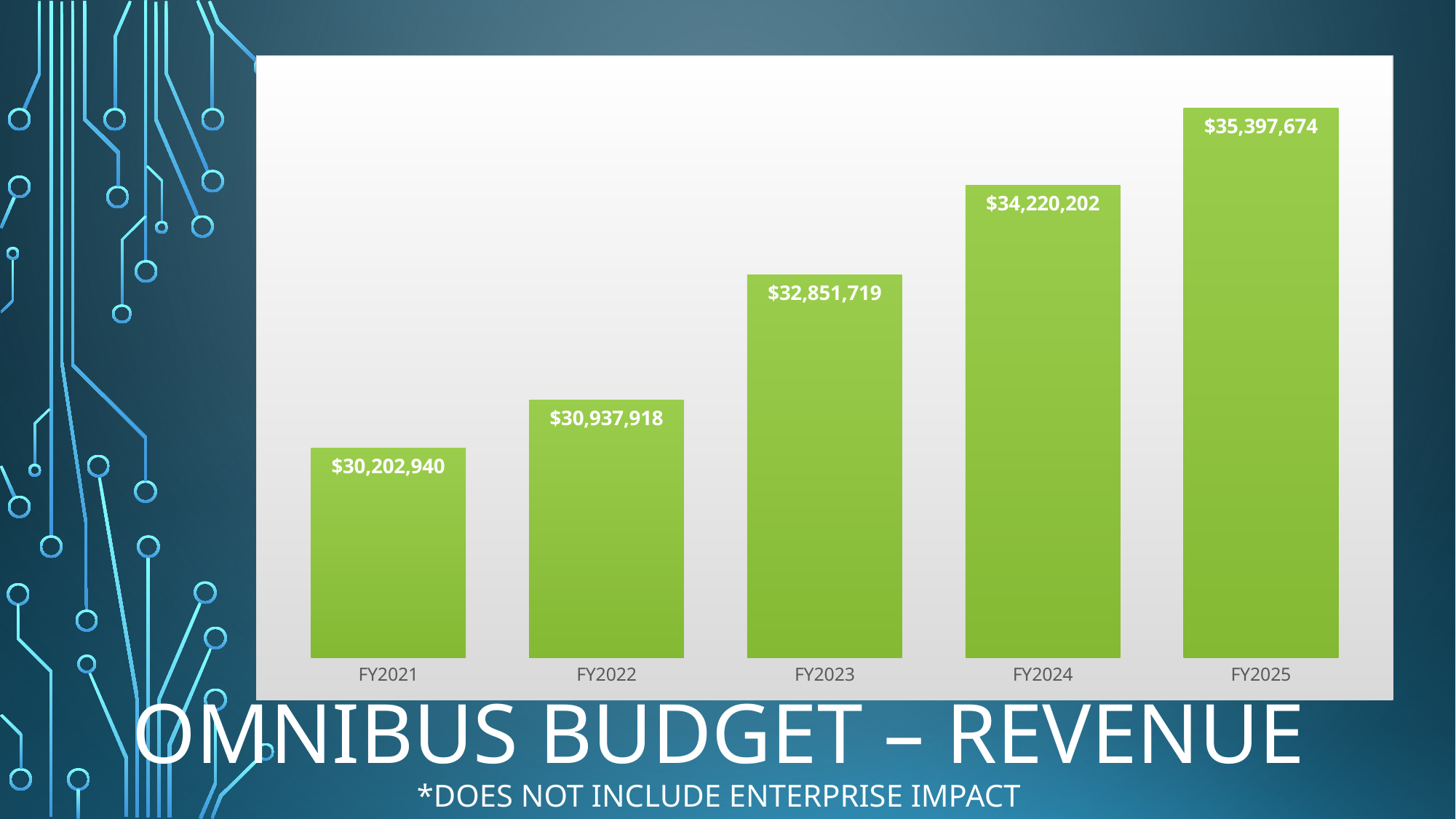
Which fiscal year has the highest revenue in the chart? FY2025 What is the revenue value shown for FY2025? $35,397,674 What is the revenue value shown for FY2021? $30,202,940 Do the revenue values rise or fall from FY2021 to FY2025? Rise How many fiscal years are shown in the chart? 5 What kind of chart is shown on the slide? Bar chart Which is larger, the revenue for FY2023 or for FY2024? FY2024 What is the difference between the FY2025 and FY2021 revenue values? $5,194,734 What is the difference between the FY2025 and FY2024 revenue values? $1,177,472 By how much does the FY2022 revenue exceed the FY2021 revenue? $734,978 What is the revenue value shown for FY2023? $32,851,719 Which fiscal year has the lowest revenue in the chart? FY2021